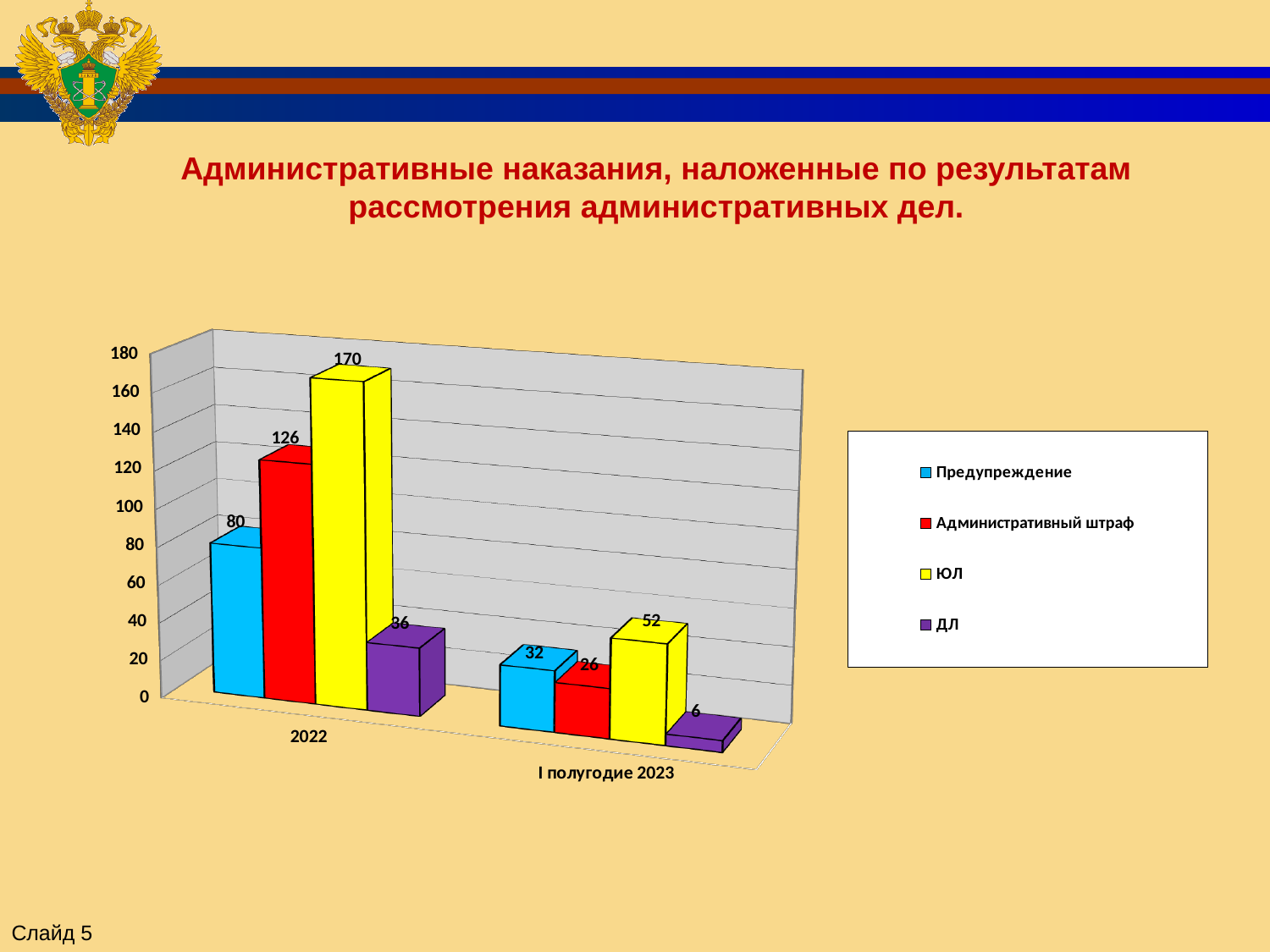
How many series does the legend list? 4 What is the value for Административный штраф in I полугодие 2023? 26 What is the difference between the ЮЛ values for 2022 and I полугодие 2023? 118 Which is larger: Предупреждение in 2022 or Административный штраф in 2022? Административный штраф in 2022 What colour represents ЮЛ in the legend? Yellow What is the value for ДЛ in 2022? 36 How many categories are shown on the x axis? 2 What is the value for Предупреждение in 2022? 80 What kind of chart is shown on the slide? Bar chart What is the value for ЮЛ in I полугодие 2023? 52 Which series has the lowest value in I полугодие 2023? ДЛ Which series has the highest value in 2022? ЮЛ